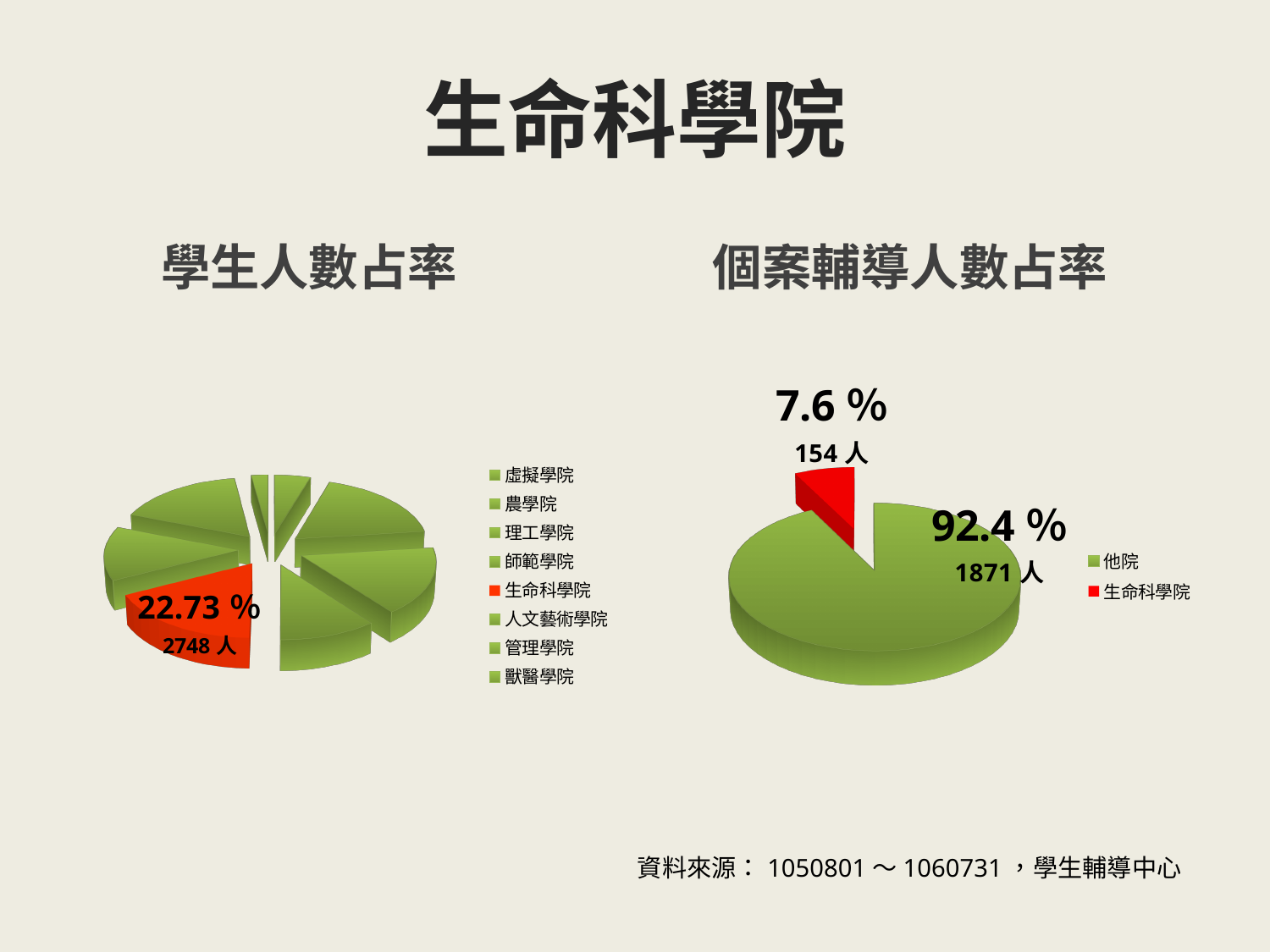
How many categories does the legend of the 學生人數占率 chart list? 8 In the 個案輔導人數占率 chart, which category has the largest share? 他院 In the 個案輔導人數占率 chart, what is the difference in people between 他院 and 生命科學院? 1717 人 What kind of chart is the 學生人數占率 chart? pie chart In the 學生人數占率 chart, how many people does the 生命科學院 slice represent? 2748 人 In the 個案輔導人數占率 chart, how many people does the 他院 slice represent? 1871 人 In the 個案輔導人數占率 chart, what percentage is shown for 他院? 92.4 % How many categories does the legend of the 個案輔導人數占率 chart list? 2 In the 學生人數占率 chart, what percentage is shown for 生命科學院? 22.73 % In the 學生人數占率 chart, which legend entry is shown in red? 生命科學院 In the 個案輔導人數占率 chart, how many people does the 生命科學院 slice represent? 154 人 In the 個案輔導人數占率 chart, what percentage is shown for 生命科學院? 7.6 %